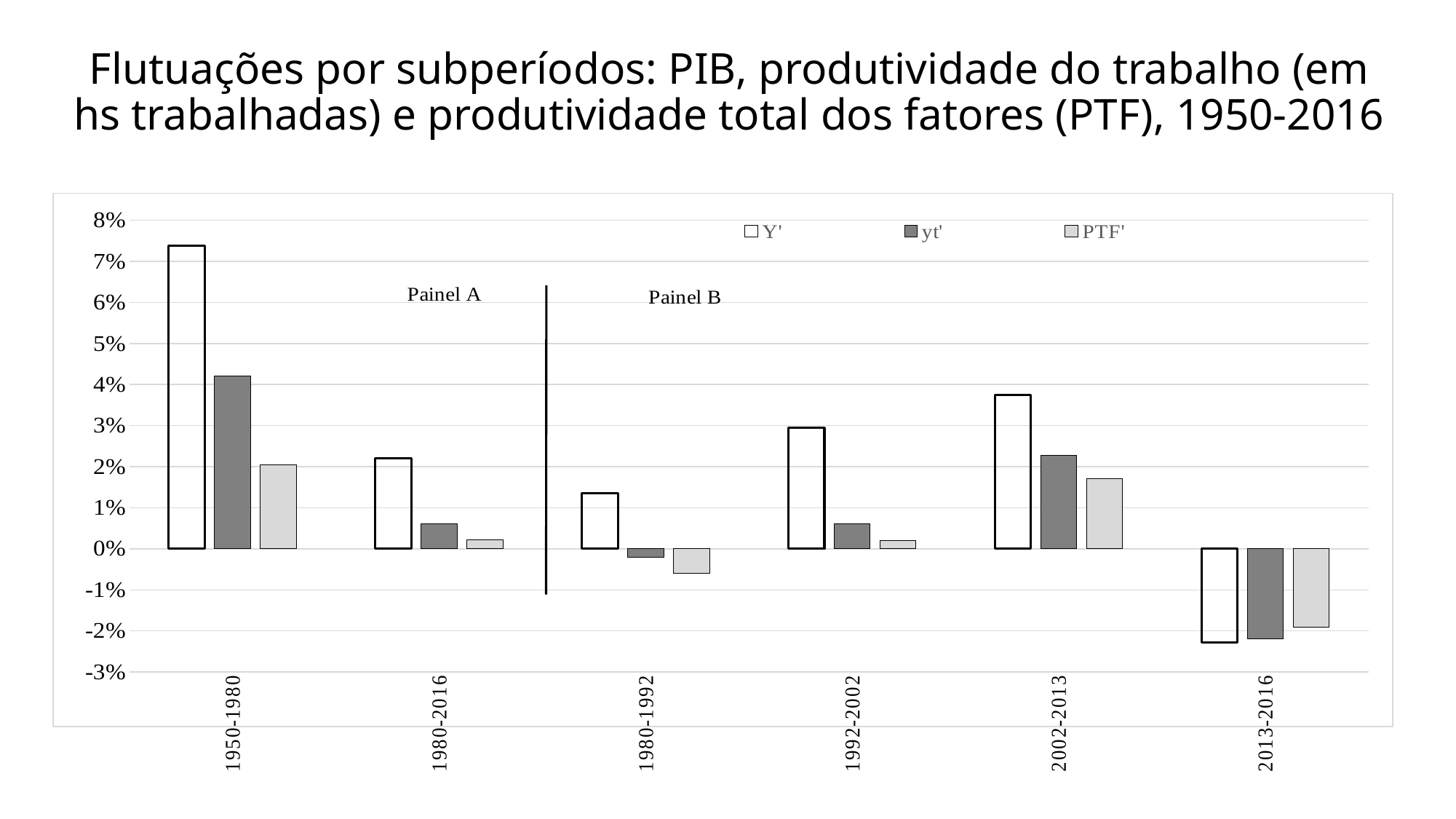
Which subperiod has the highest value for Y'? 1950-1980 What kind of chart is shown on the slide? bar chart What are the two panel labels written inside the chart? Painel A and Painel B Is the value for yt' in 1950-1980 greater or less than 3%? greater Is the value for PTF' in 1980-1992 greater or less than 0%? less Which subperiod has the lowest value for Y'? 2013-2016 Which is larger, the Y' value for 2002-2013 or the Y' value for 1992-2002? 2002-2013 Is the value for PTF' in 2002-2013 greater or less than 2%? less How many subperiod categories are shown on the x axis? 6 How many series does the legend list? 3